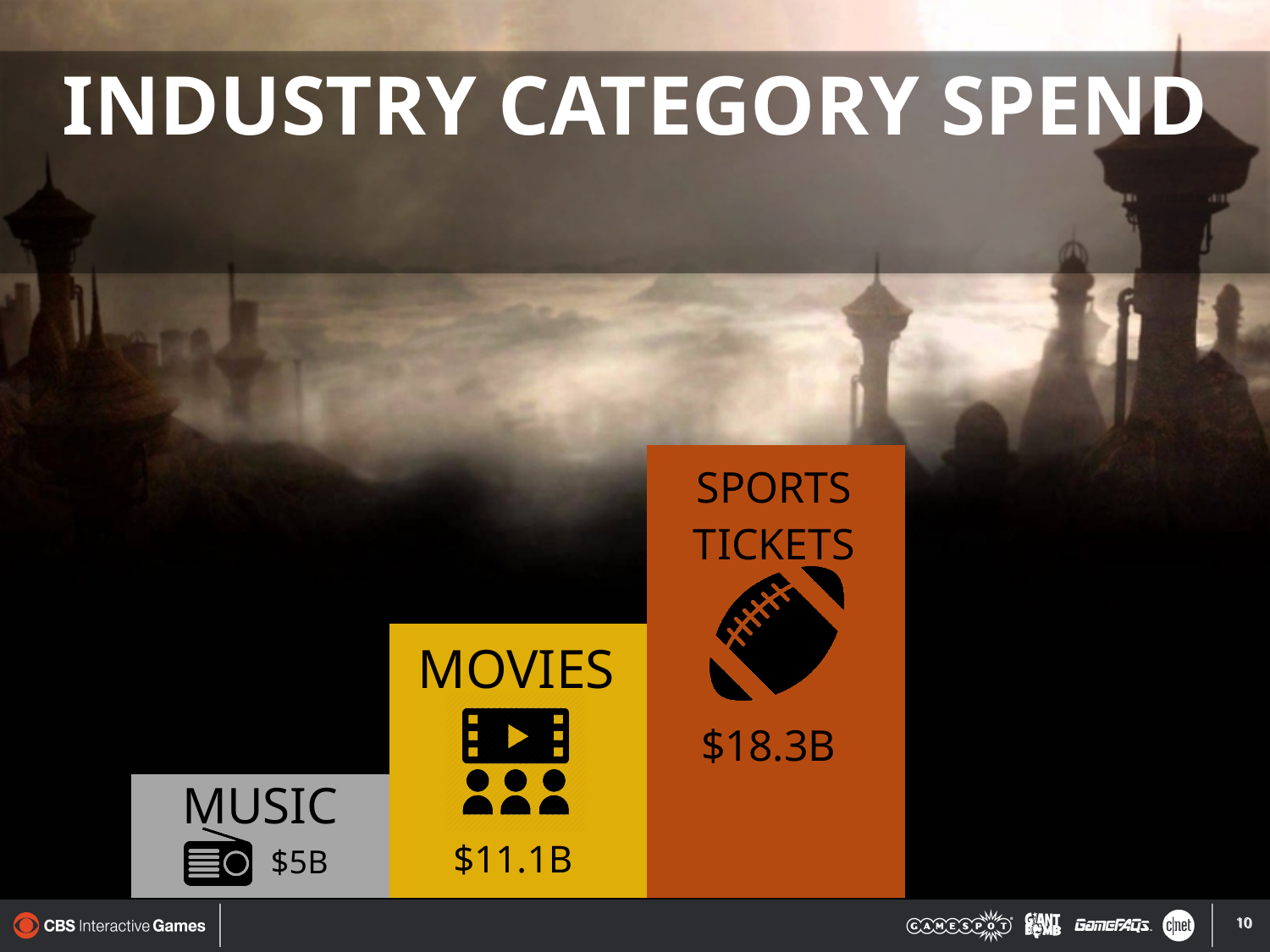
What kind of chart is shown on the slide? Bar chart What is the difference in spend between Movies and Music? $6.1B What is the spend value shown for Sports Tickets? $18.3B Which category has the highest spend? Sports Tickets Which has a larger spend, Movies or Music? Movies What is the spend value shown for Movies? $11.1B What is the difference in spend between Sports Tickets and Movies? $7.2B What is the title of the slide? Industry Category Spend What is the spend value shown for Music? $5B How many categories are shown in the chart? 3 Which category has the lowest spend? Music Do the values rise or fall from left to right across the categories? Rise